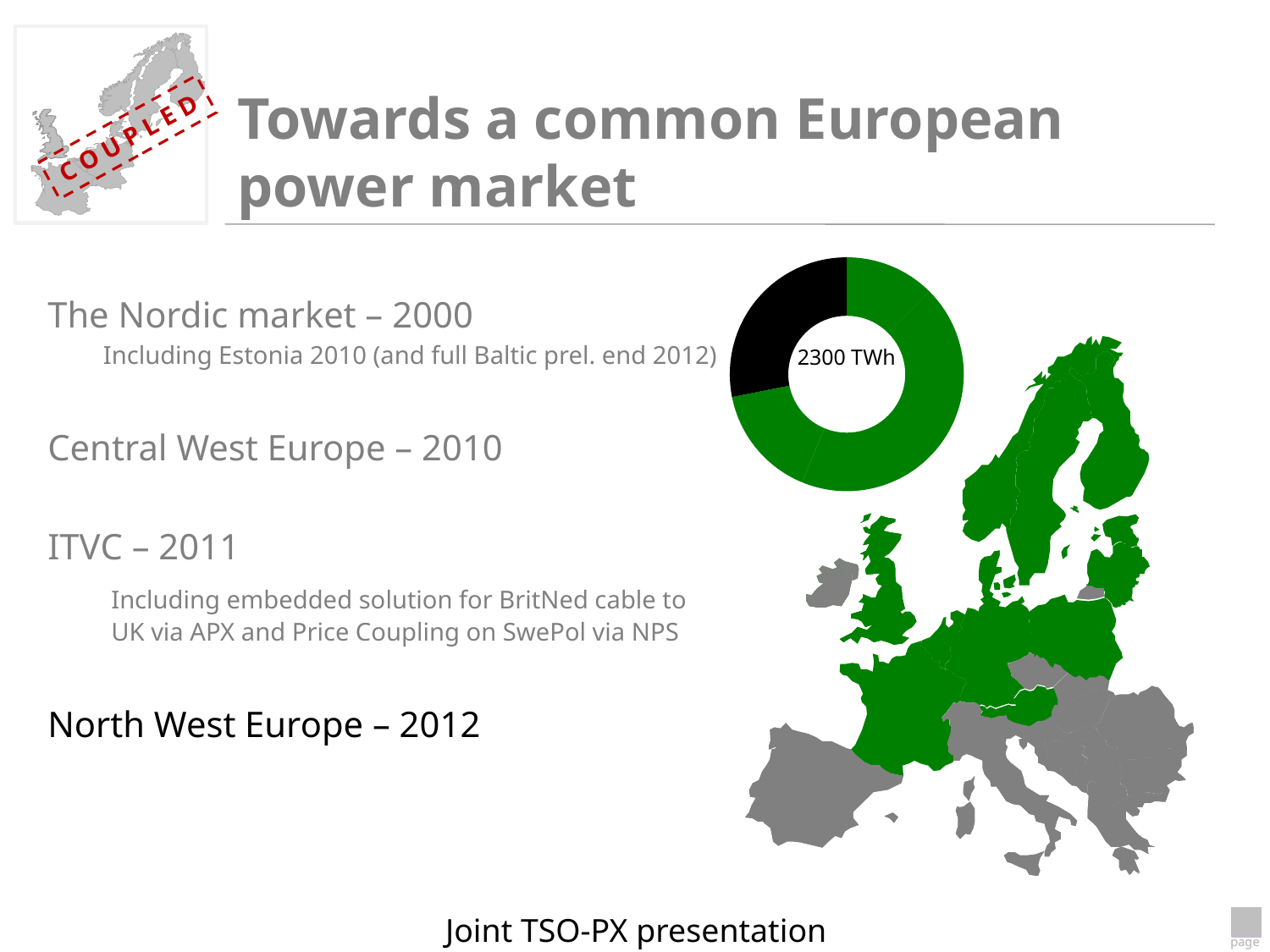
What kind of chart is shown on the right side of the slide? doughnut chart Which colour covers the larger portion of the doughnut chart, green or black? green Does the black slice of the doughnut chart cover more or less than half of the chart? less What value is printed in the centre of the doughnut chart? 2300 TWh Which two colours are used for the slices of the doughnut chart? green and black What unit is shown in the centre label of the doughnut chart? TWh